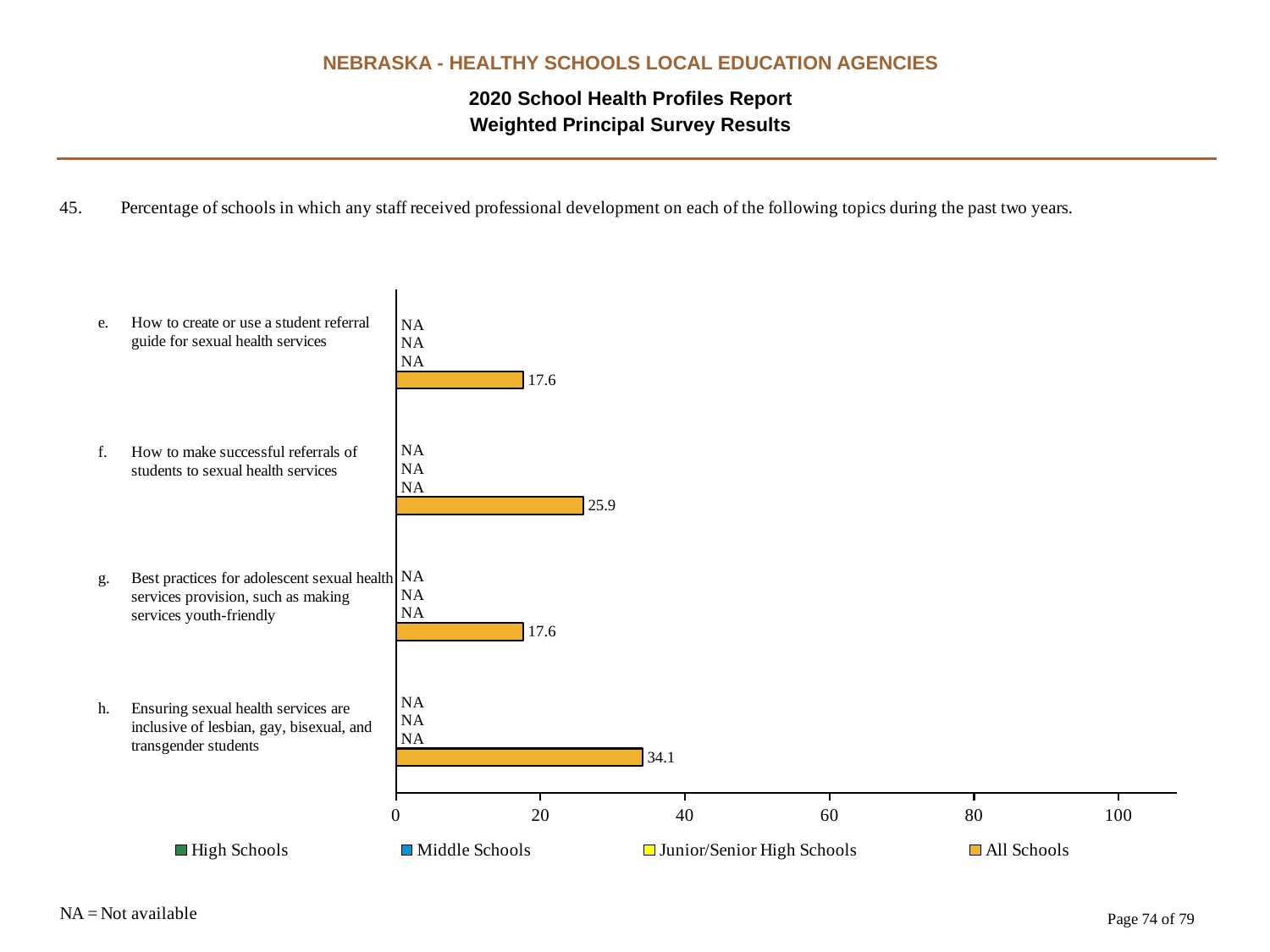
Which topic has the highest All Schools value? Ensuring sexual health services are inclusive of lesbian, gay, bisexual, and transgender students What does NA stand for according to the note on the slide? Not available What is the difference between the All Schools values for topic h (inclusive services) and topic f (successful referrals)? 8.2 What is the All Schools value for 'How to make successful referrals of students to sexual health services'? 25.9 What kind of chart is shown on the slide? bar chart Is the All Schools value for 'Ensuring sexual health services are inclusive of lesbian, gay, bisexual, and transgender students' greater or less than 40? less What is the All Schools value for 'How to create or use a student referral guide for sexual health services'? 17.6 What is the High Schools value shown for 'Best practices for adolescent sexual health services provision, such as making services youth-friendly'? NA How many topics (categories) are shown on the chart? 4 What is the All Schools value for 'Ensuring sexual health services are inclusive of lesbian, gay, bisexual, and transgender students'? 34.1 How many series does the legend list? 4 Which is larger for All Schools: 'How to make successful referrals of students to sexual health services' or 'Best practices for adolescent sexual health services provision'? How to make successful referrals of students to sexual health services